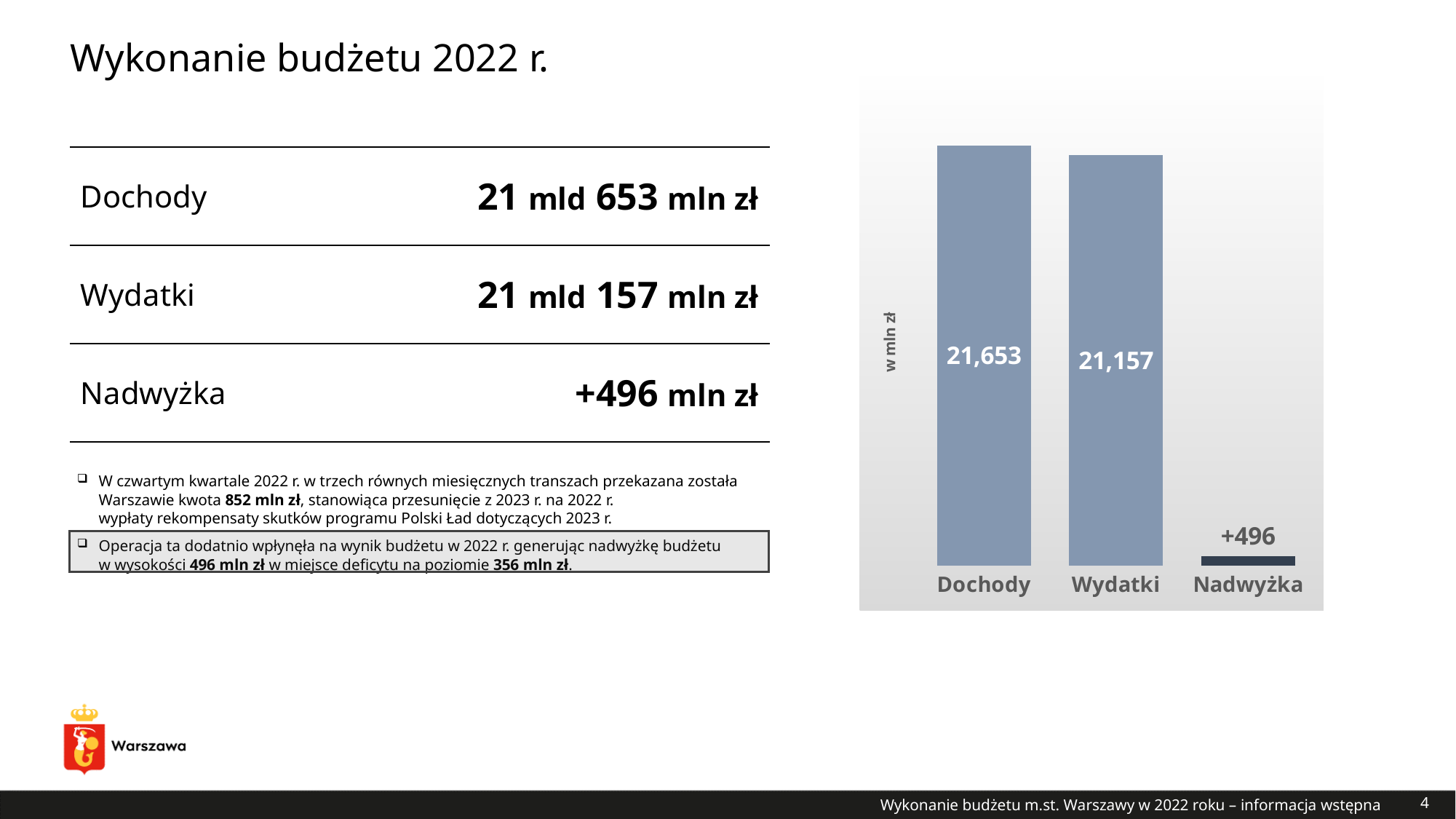
What is the value for Nadwyżka in the chart? +496 How many categories are shown in the chart? 3 What is the value for Dochody in the chart? 21,653 What unit is given on the vertical axis label of the chart? w mln zł Which is larger in the chart, Dochody or Wydatki? Dochody What is the value for Wydatki in the chart? 21,157 What is the difference between Dochody and Wydatki in the chart? 496 Which category has the lowest value in the chart? Nadwyżka Which category has the highest value in the chart? Dochody What kind of chart is shown on the slide? Bar chart Which bar in the chart is drawn in a darker colour than the others? Nadwyżka